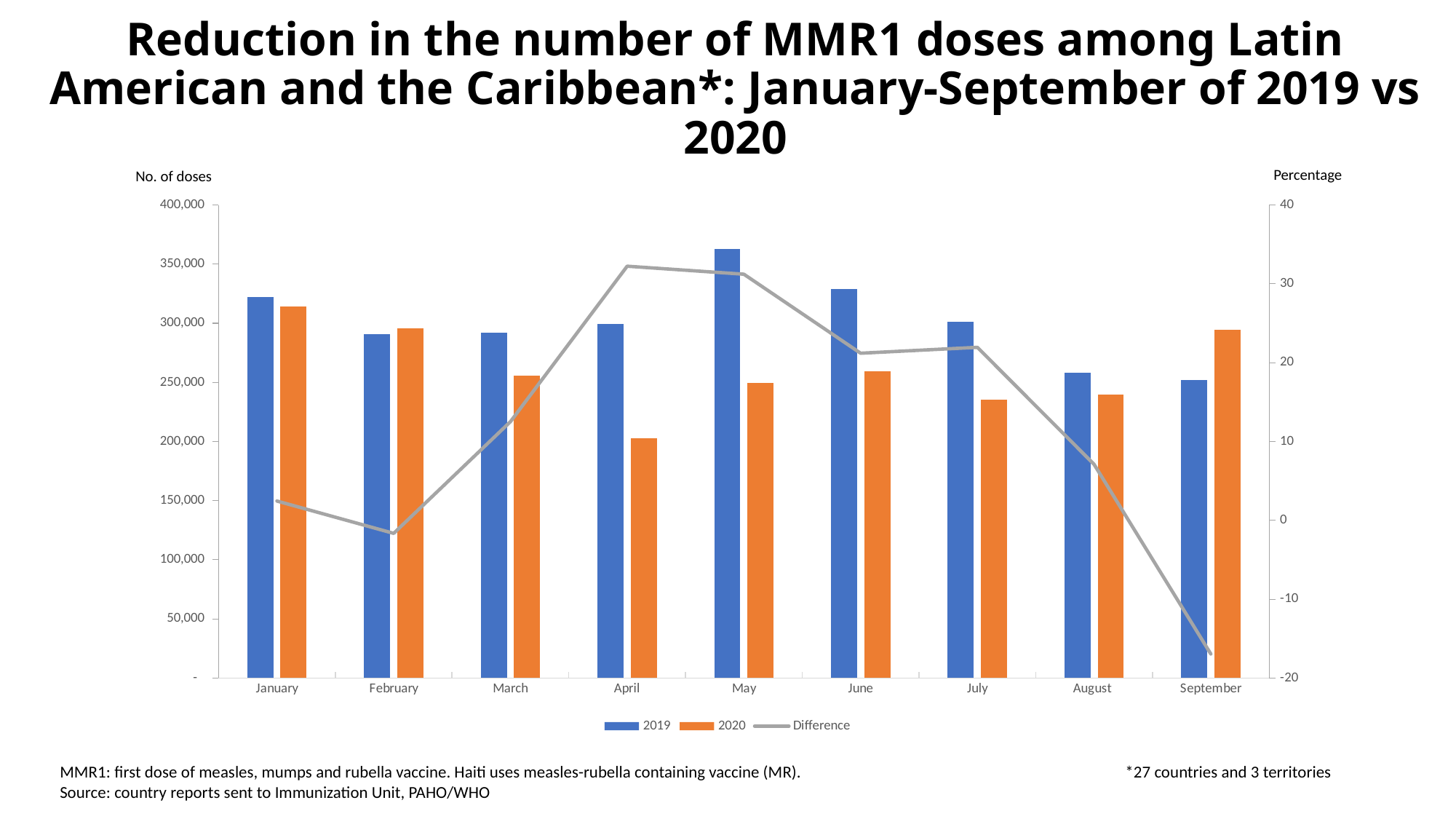
Is the 2019 value for May greater or less than 350,000? greater How many series does the legend list? 3 Is the Difference value for September greater or less than -10? less Is the Difference value for April greater or less than 20? greater Which month has the highest value for the 2020 series? January In April, which series has the larger value, 2019 or 2020? 2019 Which month has the lowest value on the Difference line? September In September, which series has the larger value, 2019 or 2020? 2020 Which month has the highest value for the 2019 series? May How many months are shown on the x axis? 9 Which month has the lowest value for the 2020 series? April